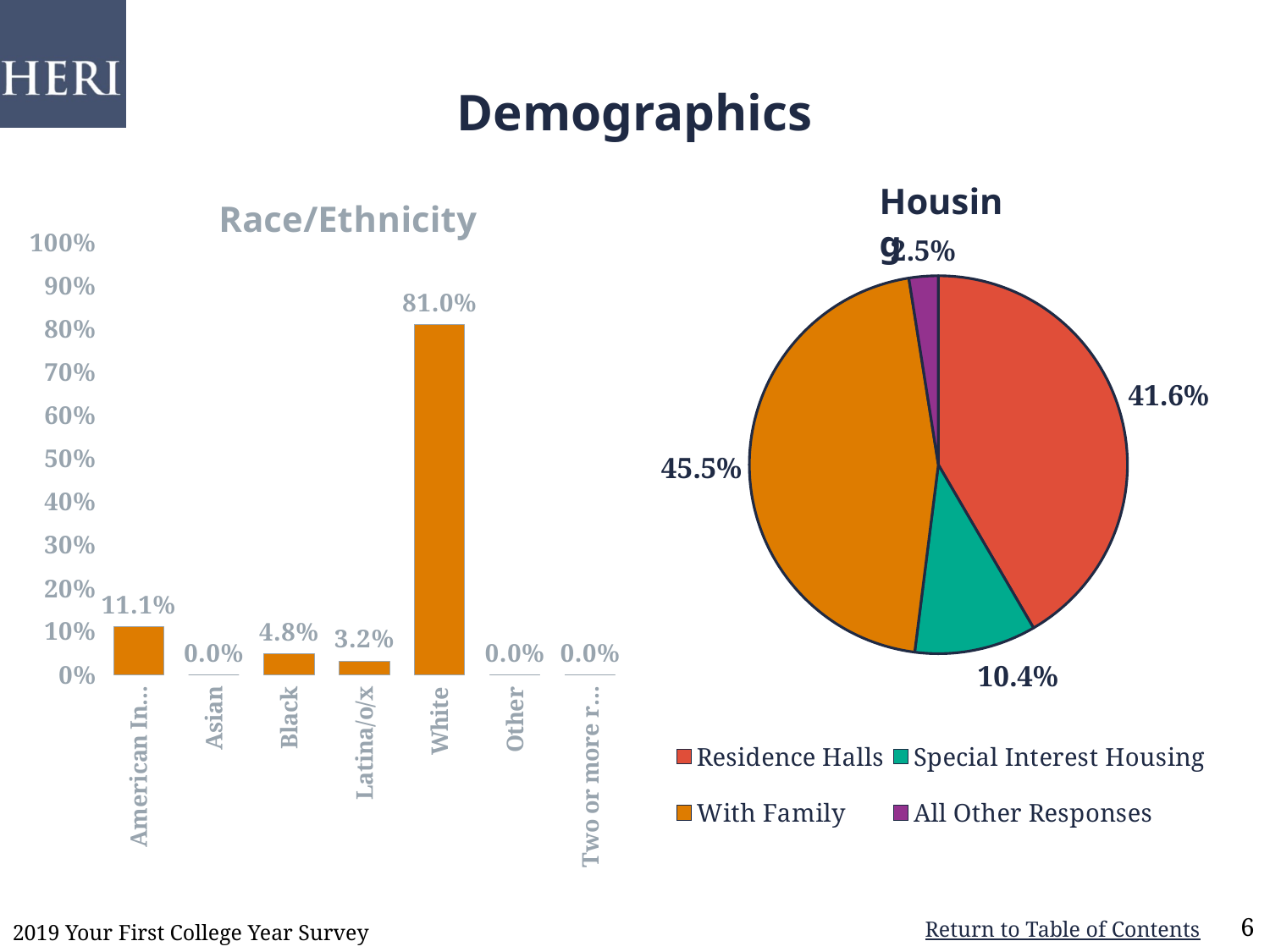
In the Housing chart, what share is With Family? 45.5% In the Race/Ethnicity chart, what is the value for White? 81.0% In the Race/Ethnicity chart, what is the difference between the values for Black and Latina/o/x? 1.6% In the Housing chart, which is larger, Residence Halls or With Family? With Family In the Race/Ethnicity chart, what is the value for Black? 4.8% In the Housing chart, what share is Special Interest Housing? 10.4% In the Race/Ethnicity chart, what is the value for Latina/o/x? 3.2% What kind of chart is the Race/Ethnicity chart? bar chart In the Race/Ethnicity chart, is the value for White greater or less than 80%? greater How many categories are shown in the Race/Ethnicity chart? 7 In the Race/Ethnicity chart, which category has the highest value? White In the Race/Ethnicity chart, what is the value for Asian? 0.0%